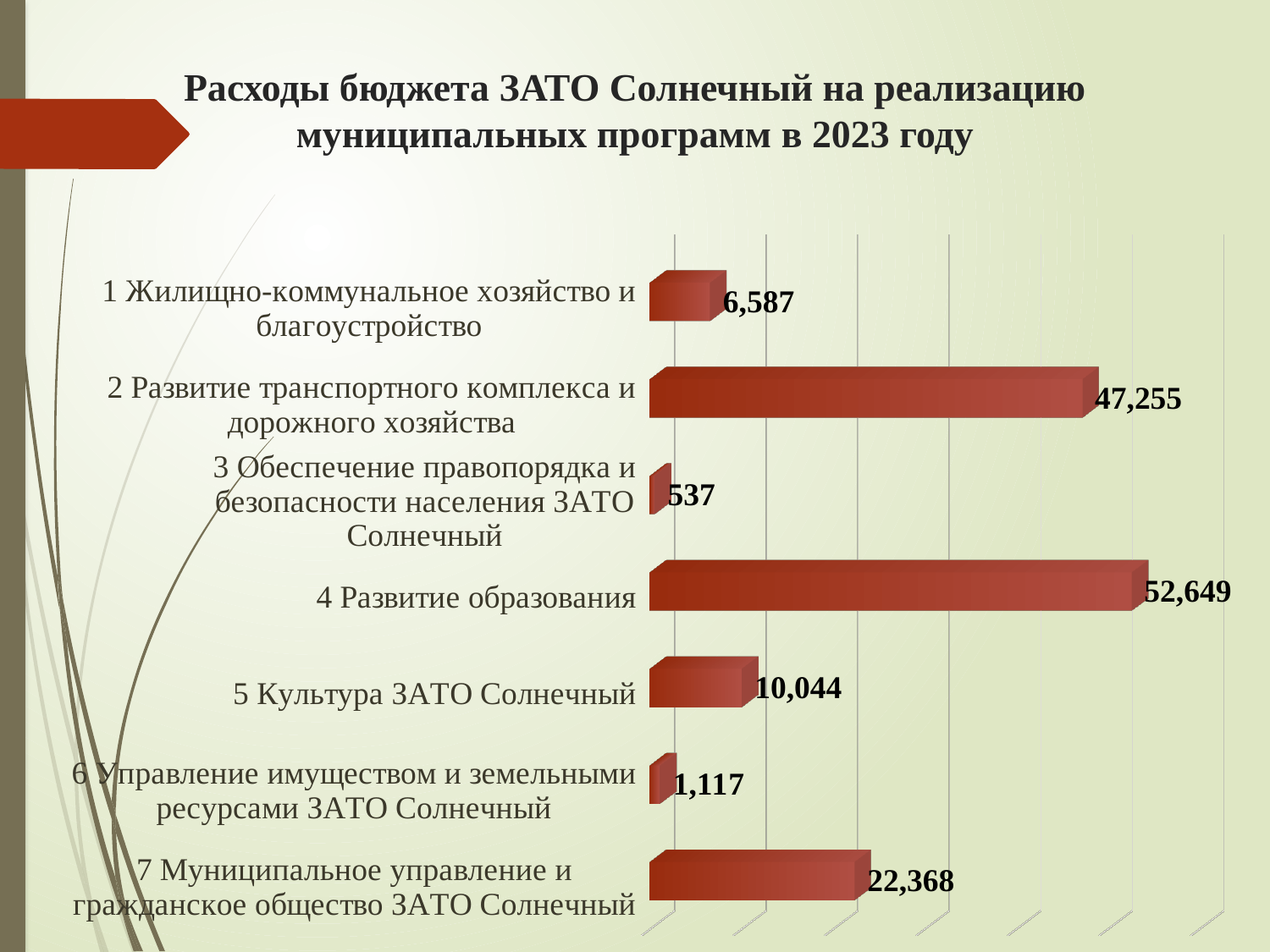
Which is larger: the value for "1 Жилищно-коммунальное хозяйство и благоустройство" or the value for "5 Культура ЗАТО Солнечный"? 5 Культура ЗАТО Солнечный Which category has the highest value? 4 Развитие образования What is the value for "7 Муниципальное управление и гражданское общество ЗАТО Солнечный"? 22,368 What is the difference between the values for "4 Развитие образования" and "2 Развитие транспортного комплекса и дорожного хозяйства"? 5,394 What is the value for "2 Развитие транспортного комплекса и дорожного хозяйства"? 47,255 What is the title of the chart on the slide? Расходы бюджета ЗАТО Солнечный на реализацию муниципальных программ в 2023 году What is the difference between the values for "7 Муниципальное управление и гражданское общество ЗАТО Солнечный" and "6 Управление имуществом и земельными ресурсами ЗАТО Солнечный"? 21,251 What type of chart is shown on the slide? Bar chart How many categories (municipal programs) are plotted in the chart? 7 What is the value for "4 Развитие образования"? 52,649 Which category has the lowest value? 3 Обеспечение правопорядка и безопасности населения ЗАТО Солнечный What is the value for "5 Культура ЗАТО Солнечный"? 10,044